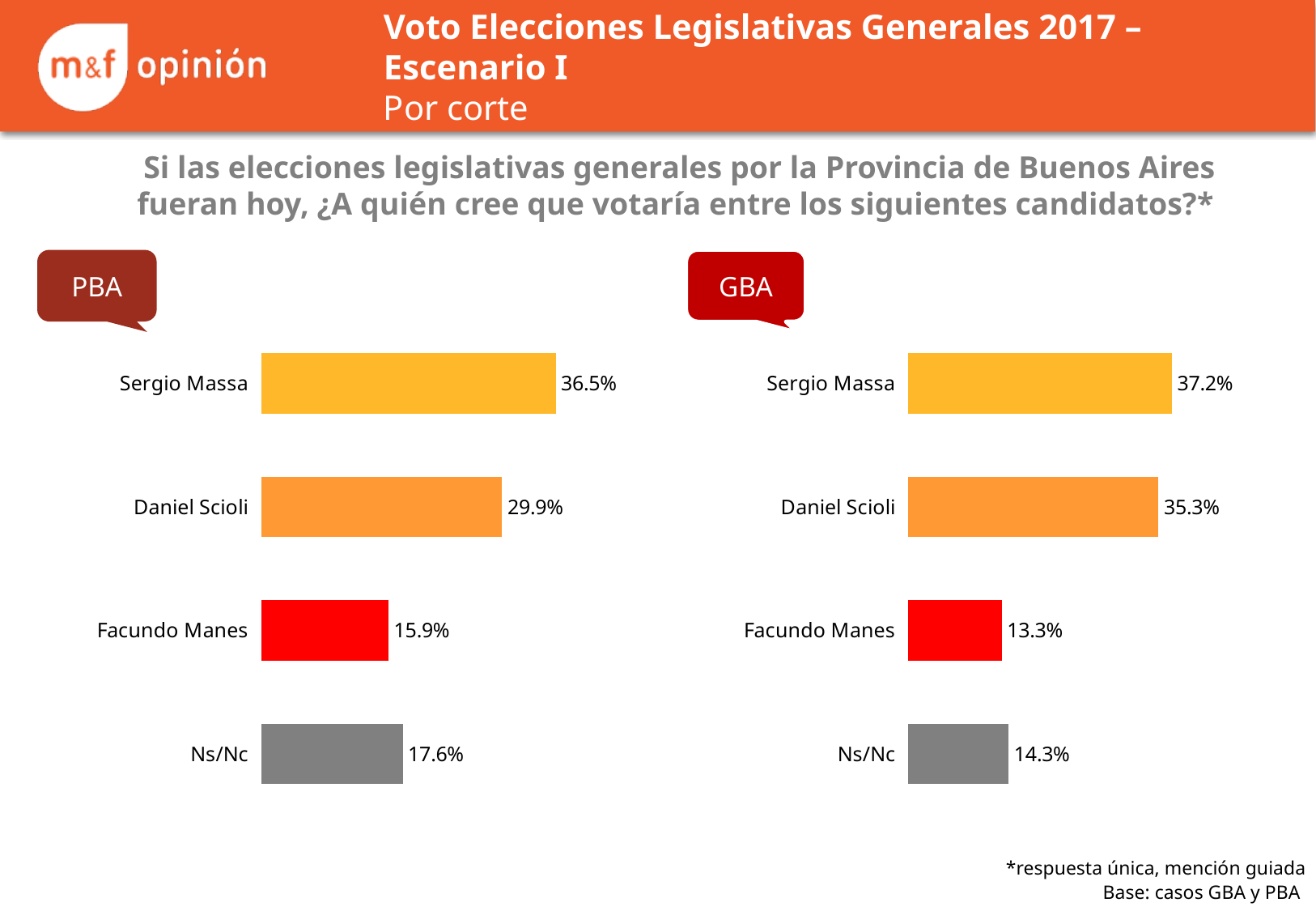
How many categories does the GBA chart show? 4 In the PBA chart, what is the value for Facundo Manes? 15.9% In the PBA chart, what is the value for Sergio Massa? 36.5% What kind of chart is the PBA chart? Bar chart In the PBA chart, which is larger, Ns/Nc or Facundo Manes? Ns/Nc In the GBA chart, what is the difference between Facundo Manes and Ns/Nc? 1.0% In the PBA chart, what is the difference between Sergio Massa and Daniel Scioli? 6.6% In the GBA chart, what colour is the bar for Facundo Manes? Red In the PBA chart, which category has the lowest value? Facundo Manes In the GBA chart, which category has the highest value? Sergio Massa In the GBA chart, what is the value for Daniel Scioli? 35.3% In the GBA chart, what is the value for Ns/Nc? 14.3%